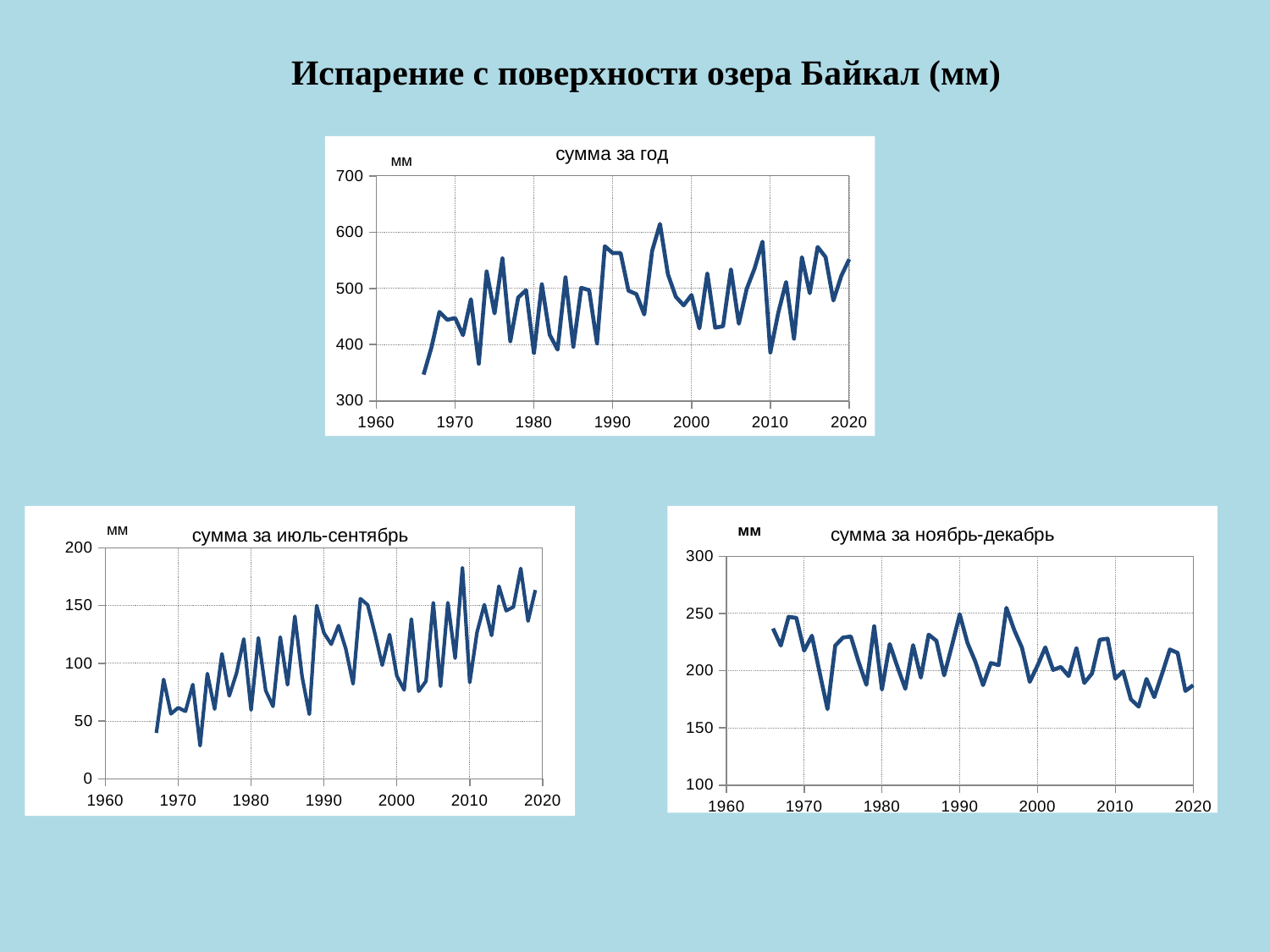
What is the title of the bottom-left chart? сумма за июль-сентябрь In the bottom-right chart "сумма за ноябрь-декабрь", is the lowest value (around 1973) greater or less than 200? less In the bottom-right chart "сумма за ноябрь-декабрь", do the values generally rise or fall from 1966 to 2019? fall How many charts are shown on the slide? 3 In the top chart "сумма за год", what is the highest value shown on the y axis? 700 In the top chart "сумма за год", is the value for 1966 greater or less than 400? less What unit is written at the top of the y axis of the bottom-right chart "сумма за ноябрь-декабрь"? мм In the bottom-left chart "сумма за июль-сентябрь", is the highest value (around 2009) greater or less than 150? greater In the bottom-left chart "сумма за июль-сентябрь", do the values generally rise or fall from 1967 to 2019? rise What kind of chart is the top chart titled "сумма за год"? line chart